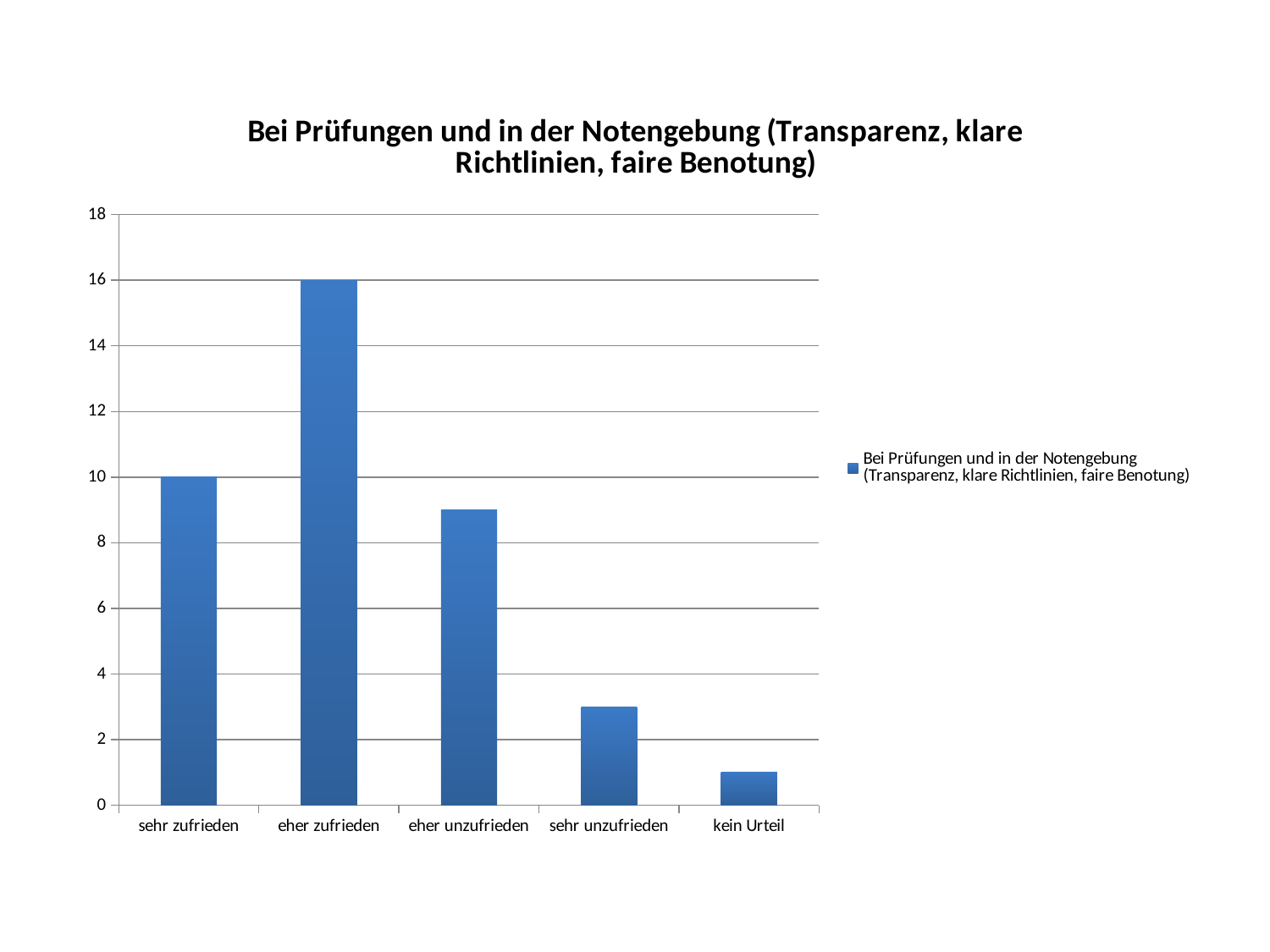
Is the value for "sehr unzufrieden" greater or less than 4? less What is the value for "sehr zufrieden"? 10 Which is larger, the value for "eher unzufrieden" or the value for "sehr unzufrieden"? eher unzufrieden What kind of chart is shown on the slide? bar chart What is the value for "eher zufrieden"? 16 Is the value for "kein Urteil" greater or less than 2? less Which category has the lowest value? kein Urteil Which category has the highest value? eher zufrieden How many series does the legend list? 1 What is the difference between the values for "eher zufrieden" and "sehr zufrieden"? 6 Is the value for "eher unzufrieden" greater or less than 8? greater How many categories are shown on the x axis? 5